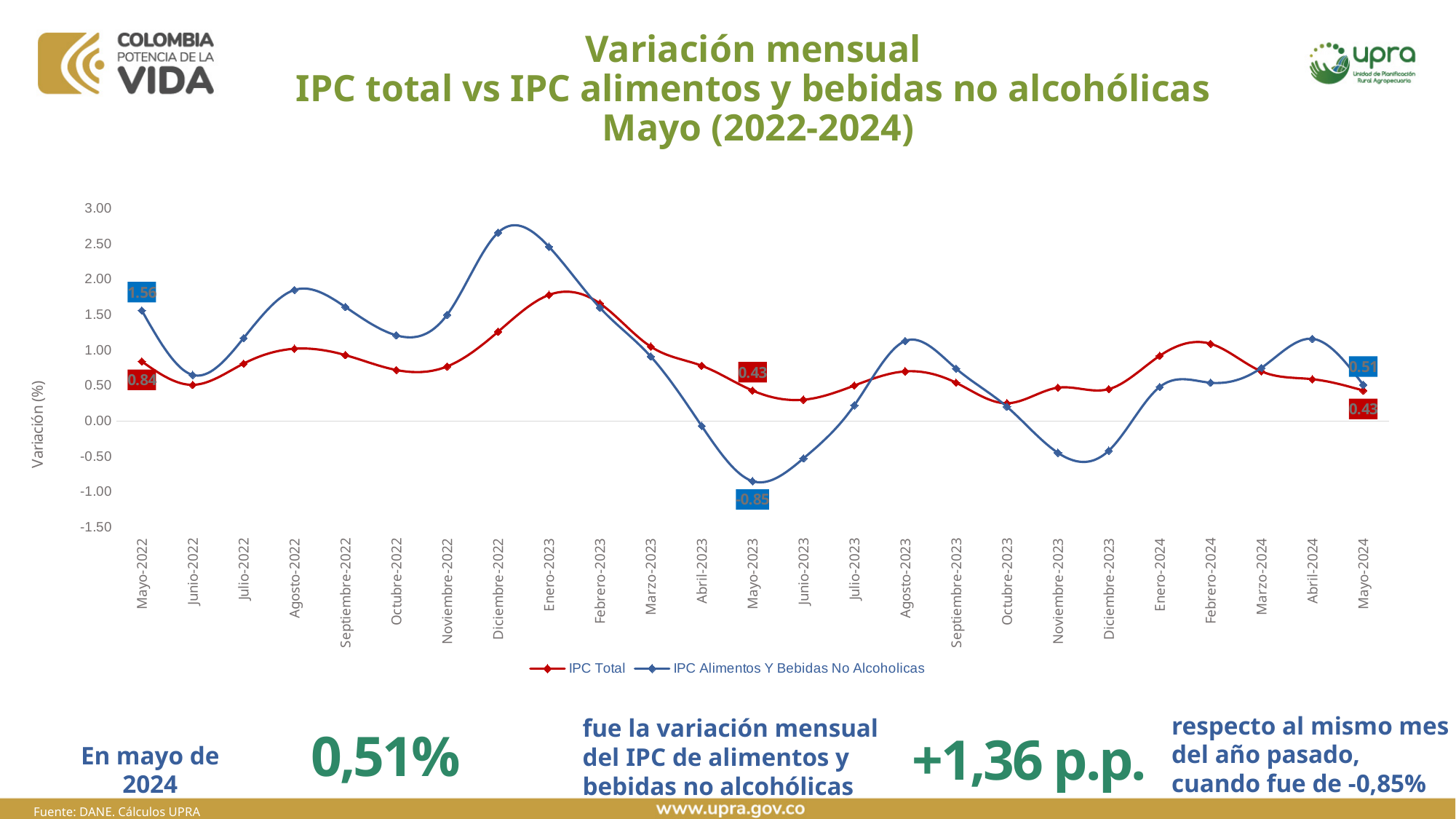
Is the value of IPC Alimentos Y Bebidas No Alcoholicas for Diciembre-2022 greater or less than 2.50? greater What kind of chart is shown on the slide? Line chart In which month does IPC Alimentos Y Bebidas No Alcoholicas reach its highest value? Diciembre-2022 What is the difference between IPC Alimentos Y Bebidas No Alcoholicas and IPC Total in Mayo-2022? 0.72 What is the value of IPC Alimentos Y Bebidas No Alcoholicas for Mayo-2023? -0.85 How many series does the legend list? 2 What is the value of IPC Alimentos Y Bebidas No Alcoholicas for Mayo-2024? 0.51 In which month does IPC Alimentos Y Bebidas No Alcoholicas reach its lowest value? Mayo-2023 What is the value of IPC Total for Mayo-2022? 0.84 Which series has the larger value in Mayo-2022, IPC Total or IPC Alimentos Y Bebidas No Alcoholicas? IPC Alimentos Y Bebidas No Alcoholicas Is the value of IPC Alimentos Y Bebidas No Alcoholicas for Noviembre-2023 greater or less than 0.00? less What is the value of IPC Total for Mayo-2024? 0.43